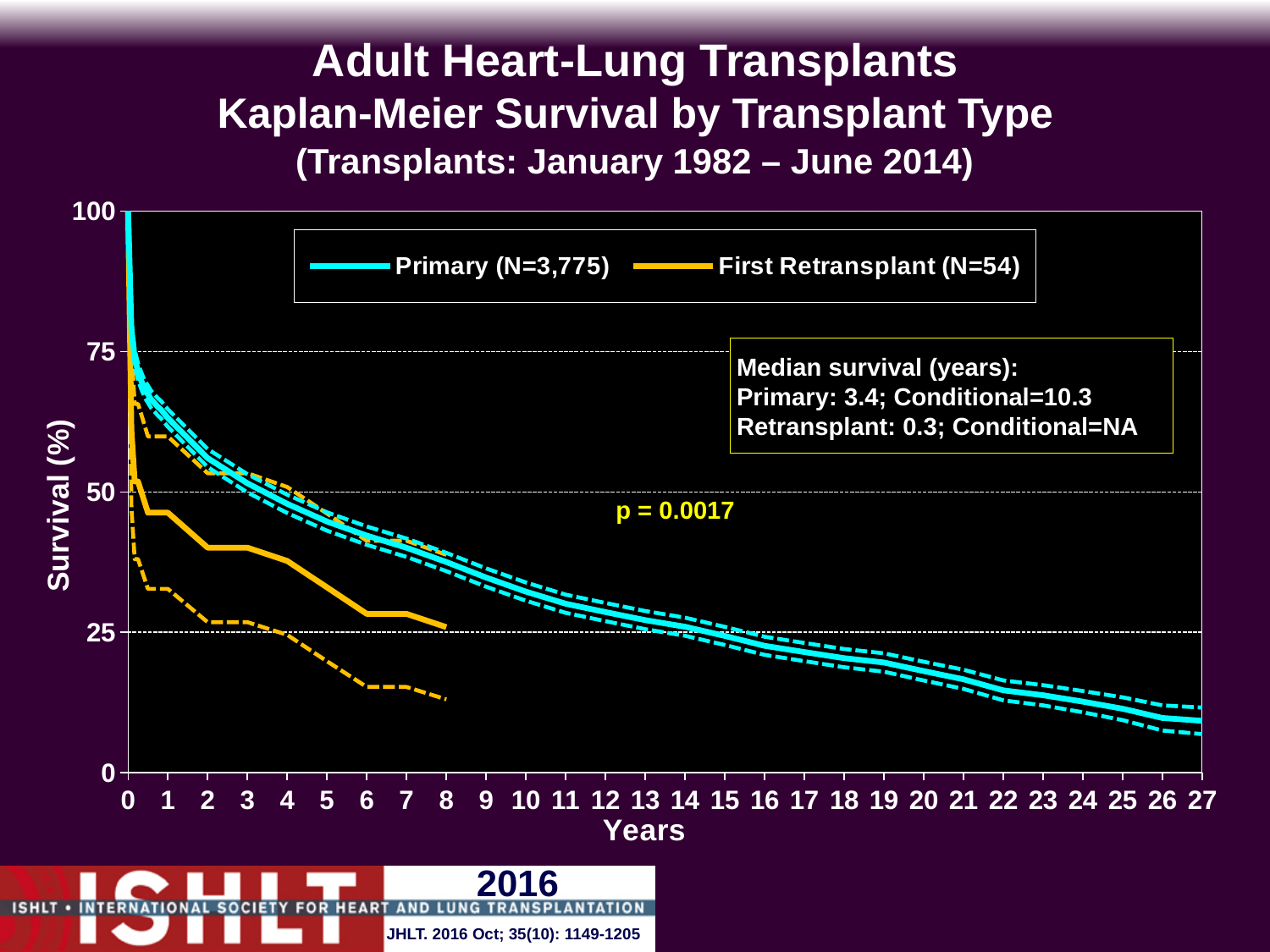
Do the survival curves rise or fall as years increase along the x axis? Fall At year 5, which series has the higher survival, Primary or First Retransplant? Primary What kind of chart is shown on the slide? Line chart What is the median survival in years for Retransplant? 0.3 What is the median survival in years for Primary transplants? 3.4 What is the sample size (N) for the First Retransplant series in the legend? 54 What is the sample size (N) for the Primary series in the legend? 3,775 Is the Primary survival value at year 20 greater or less than 25? less What is the conditional median survival in years for Primary transplants? 10.3 What p-value is shown on the chart? p = 0.0017 Is the Primary survival value at year 10 greater or less than 25? greater How many series does the legend list? 2